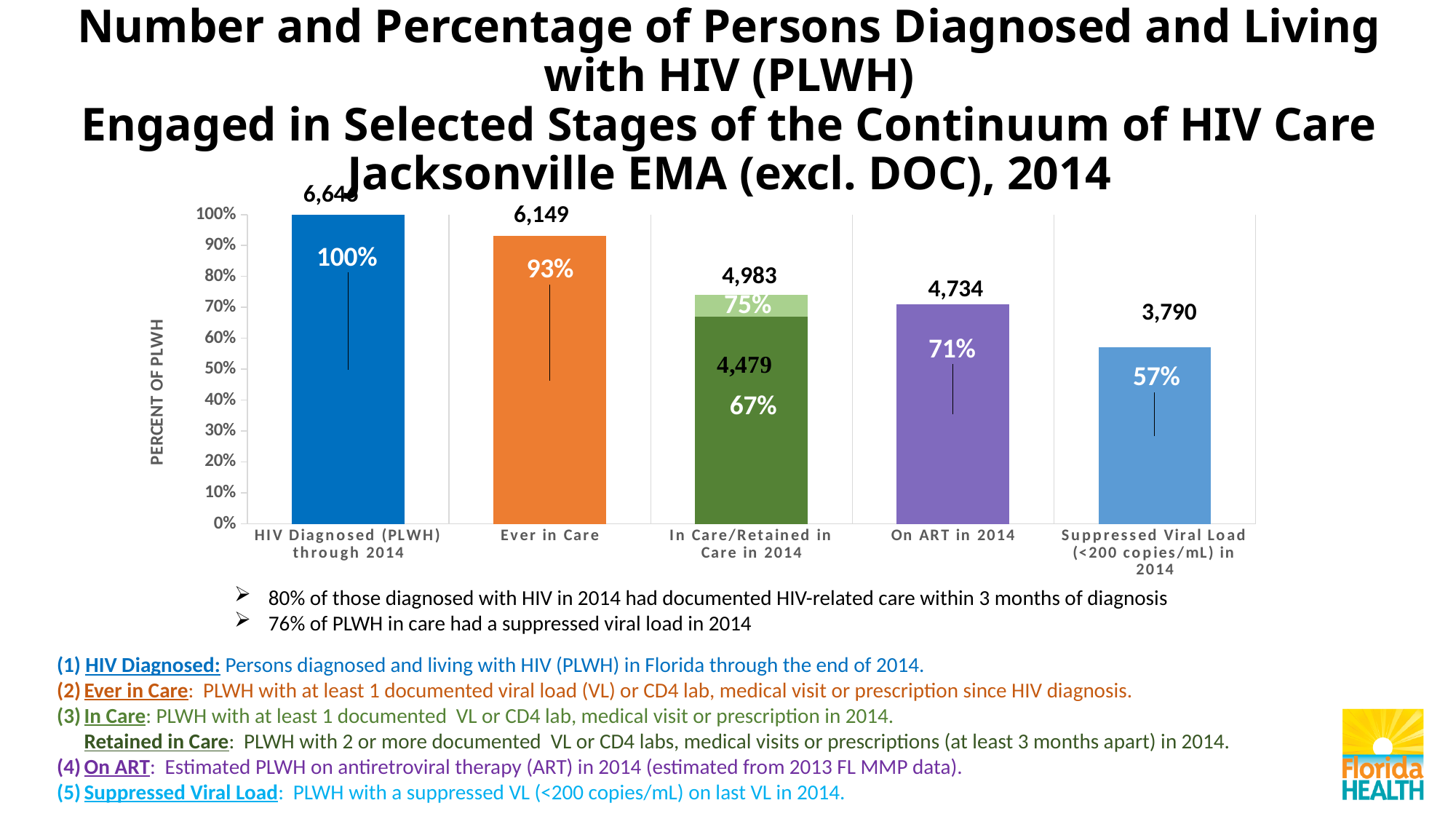
What type of chart is shown on the slide? Bar chart What percentage is shown for Suppressed Viral Load (<200 copies/mL) in 2014? 57% Which stage of the continuum has the highest percentage of PLWH? HIV Diagnosed (PLWH) through 2014 Which is larger, the percentage for On ART in 2014 or the percentage for Suppressed Viral Load in 2014? On ART in 2014 What number is labelled for Retained in Care (the darker green portion) in 2014? 4,479 What number is labelled above the On ART in 2014 bar? 4,734 How many stages of the continuum of care are shown on the x axis? 5 What percentage is shown for In Care in 2014 (the lighter green top of the bar)? 75% What is the difference in number of persons between Ever in Care (6,149) and Suppressed Viral Load (3,790)? 2,359 Which stage of the continuum has the lowest percentage of PLWH? Suppressed Viral Load (<200 copies/mL) in 2014 What percentage is shown for the Ever in Care bar? 93%